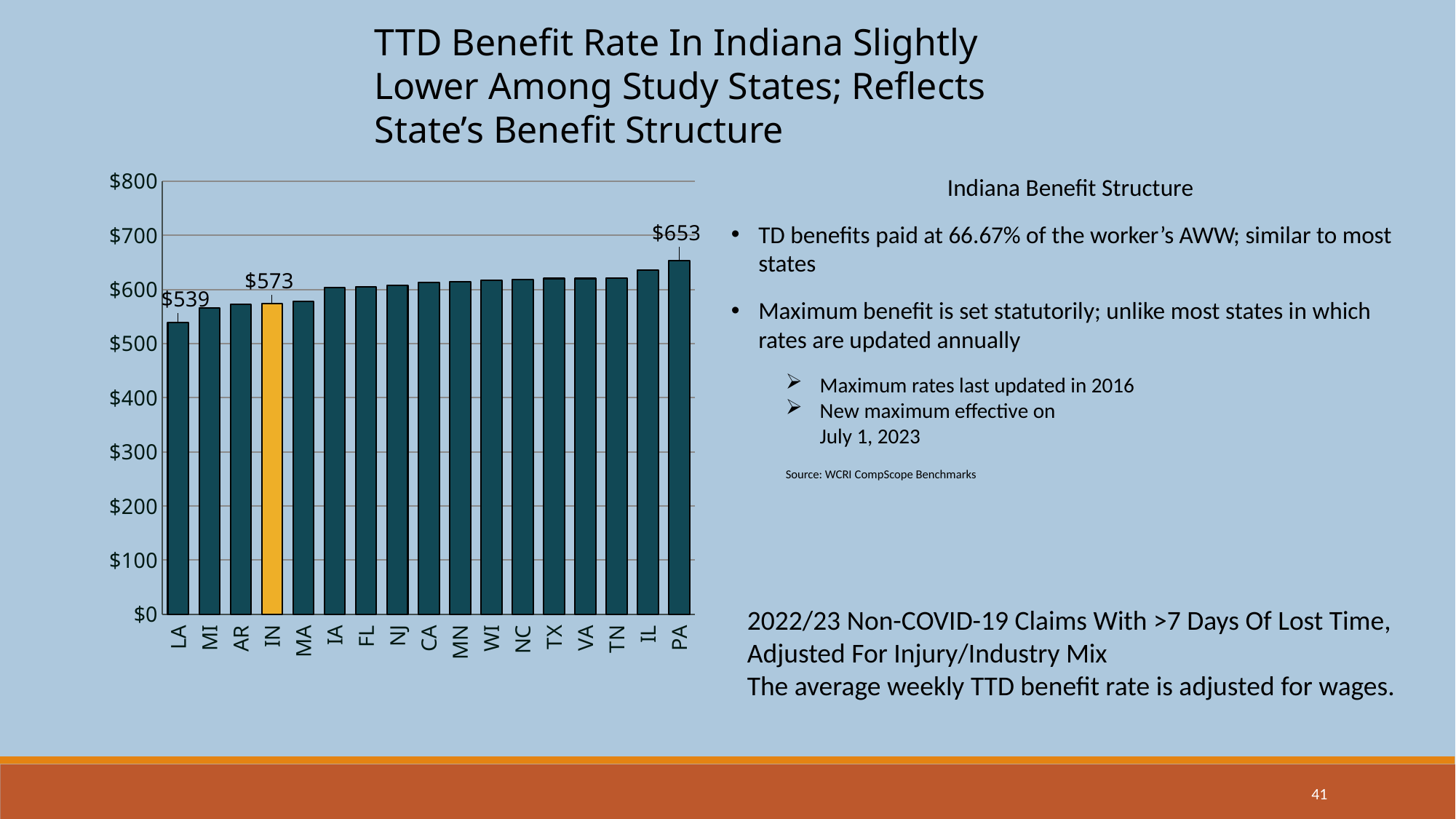
What kind of chart is shown on the slide? Bar chart Is the value for IL greater or less than $600? greater What is the TTD benefit rate shown for PA? $653 How many states are shown in the bar chart? 17 What is the difference between the TTD benefit rates for IN and LA? $34 What is the TTD benefit rate shown for IN? $573 Which has a higher TTD benefit rate, IN or PA? PA Do the values rise or fall moving from left to right along the x axis? Rise Which state has the lowest TTD benefit rate in the chart? LA What is the difference between the TTD benefit rates for PA and IN? $80 Which state has the highest TTD benefit rate in the chart? PA What is the TTD benefit rate shown for LA? $539